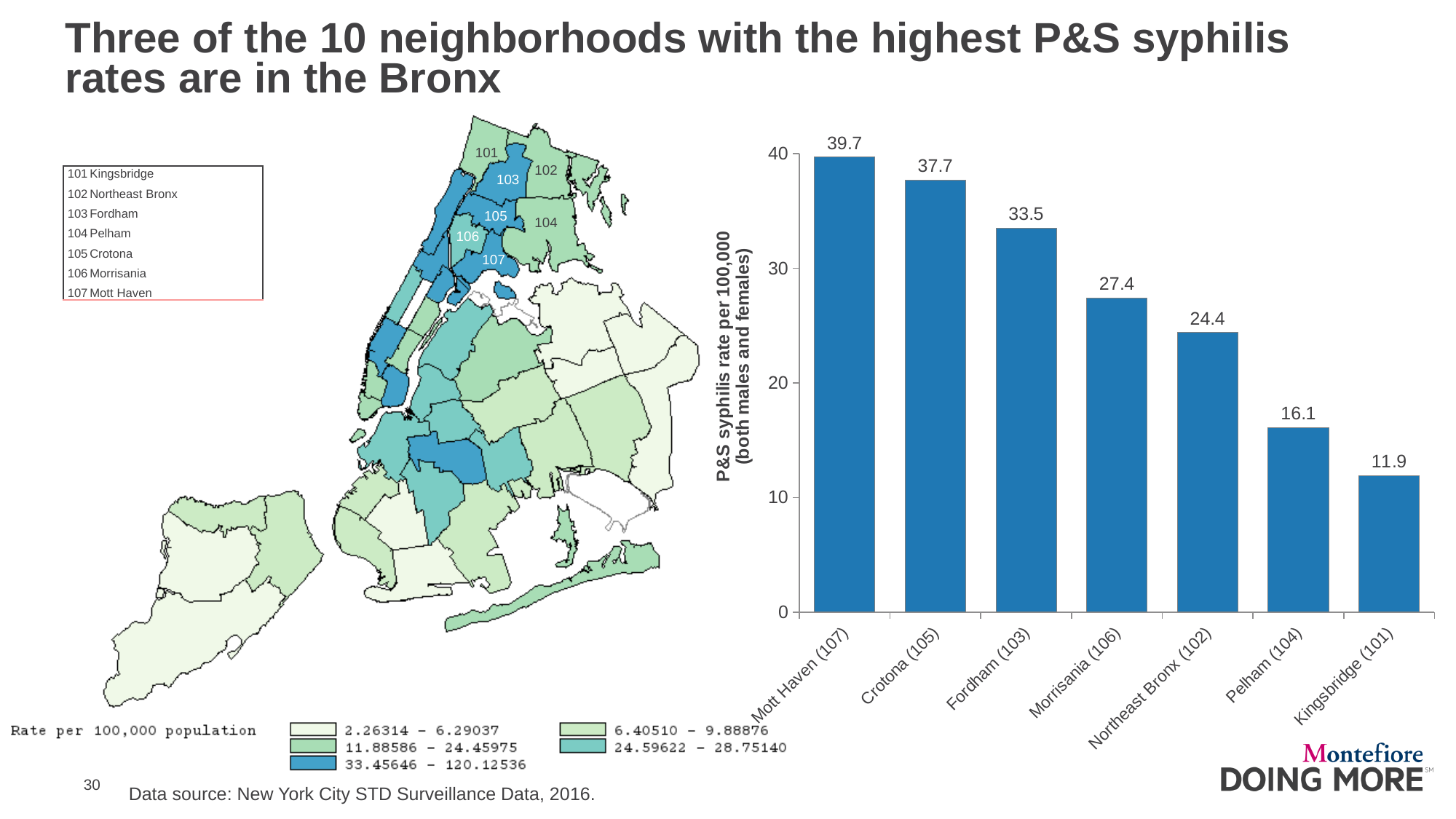
How many neighborhoods are shown in the bar chart? 7 Is the P&S syphilis rate for Fordham (103) greater or less than 30? greater Which neighborhood has the lowest P&S syphilis rate in the bar chart? Kingsbridge (101) Do the P&S syphilis rates rise or fall from left to right across the bar chart? fall What is the P&S syphilis rate per 100,000 for Mott Haven (107)? 39.7 What is the difference between the P&S syphilis rates of Mott Haven (107) and Crotona (105)? 2.0 Which has a higher P&S syphilis rate, Morrisania (106) or Pelham (104)? Morrisania (106) What is the P&S syphilis rate per 100,000 for Pelham (104)? 16.1 What kind of chart is used to show the P&S syphilis rates by neighborhood? bar chart What is the P&S syphilis rate per 100,000 for Northeast Bronx (102)? 24.4 What is the difference between the P&S syphilis rates of Fordham (103) and Kingsbridge (101)? 21.6 Which neighborhood has the highest P&S syphilis rate in the bar chart? Mott Haven (107)